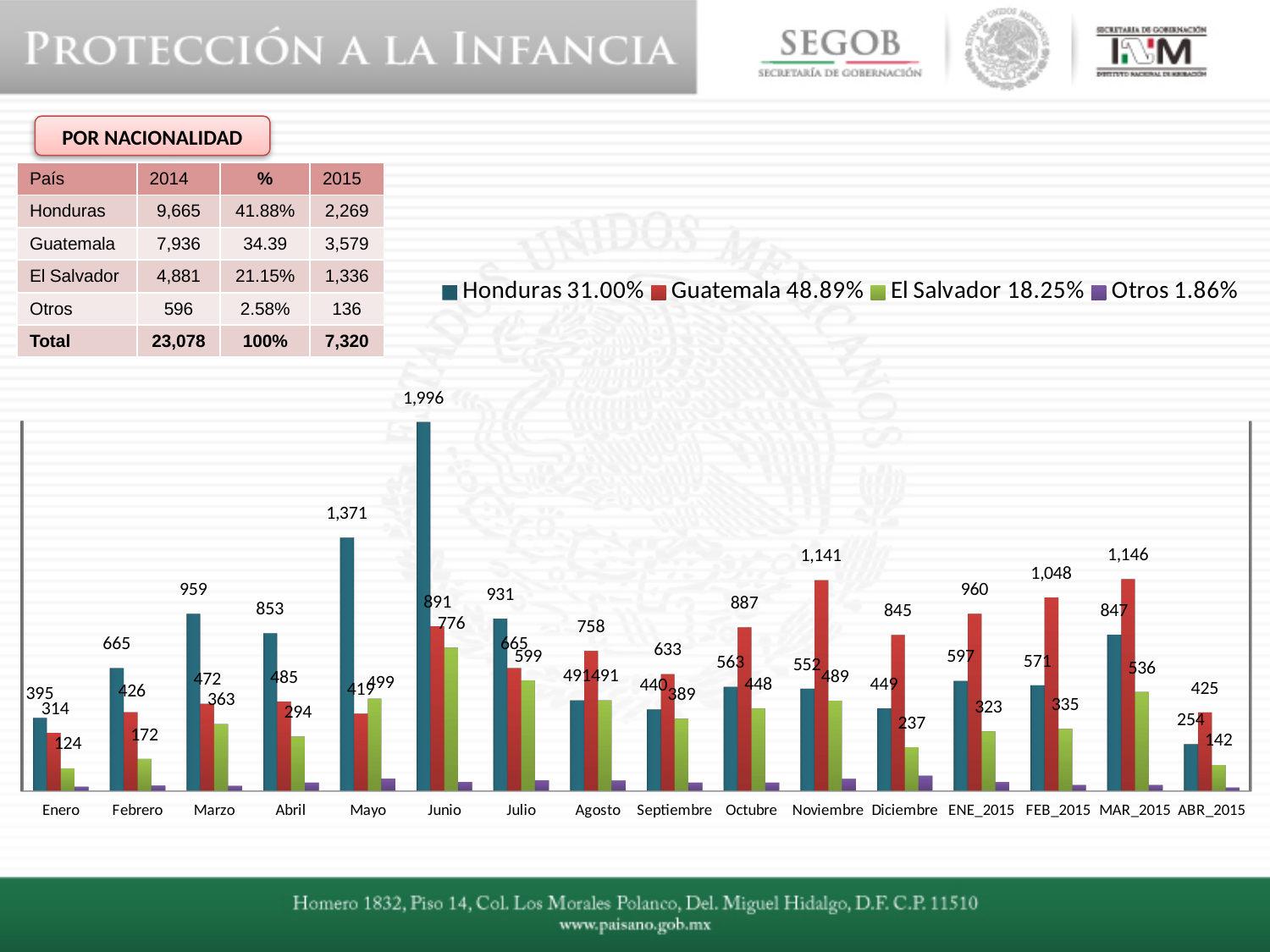
What is the difference between the Honduras value in Mayo and the Honduras value in Abril? 518 Does the Guatemala value rise or fall from Diciembre to MAR_2015? rise What is the value for El Salvador in Diciembre? 237 What percentage is shown next to Guatemala in the chart legend? 48.89% How many month categories are shown along the x axis of the chart? 16 In which month is the Honduras value highest? Junio How many series does the chart legend list? 4 What is the value for Honduras in Junio? 1,996 What is the value for Guatemala in MAR_2015? 1,146 Which is larger in Noviembre, the Guatemala value or the Honduras value? Guatemala In which month is the El Salvador value lowest? Enero What type of chart is shown on the slide? bar chart